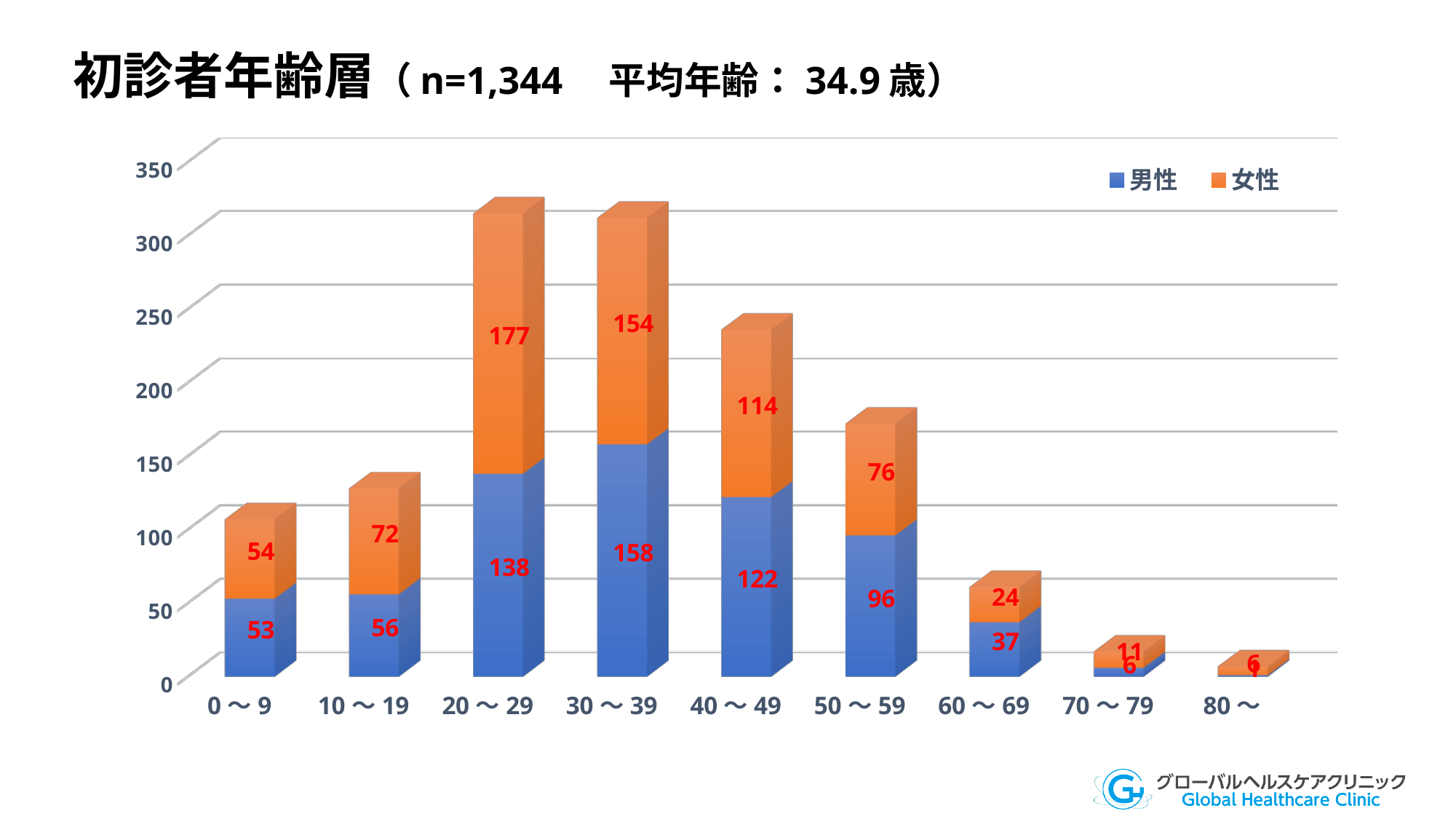
What kind of chart is shown on the slide? Stacked bar chart In the 20～29 age group, how much larger is the 女性 value than the 男性 value? 39 What is the total of the stacked bar for the 40～49 age group? 236 How many age groups are shown on the x axis? 9 Is the total of the stacked bar for the 50～59 age group greater or less than 150? greater Which age group has the highest 男性 value? 30～39 Which age group has the highest 女性 value? 20～29 How many series does the legend list? 2 What is the value for 女性 in the 60～69 age group? 24 What is the value for 男性 in the 20～29 age group? 138 Which is larger, the 男性 value for 10～19 or for 0～9? 10～19 What is the value for 女性 in the 30～39 age group? 154